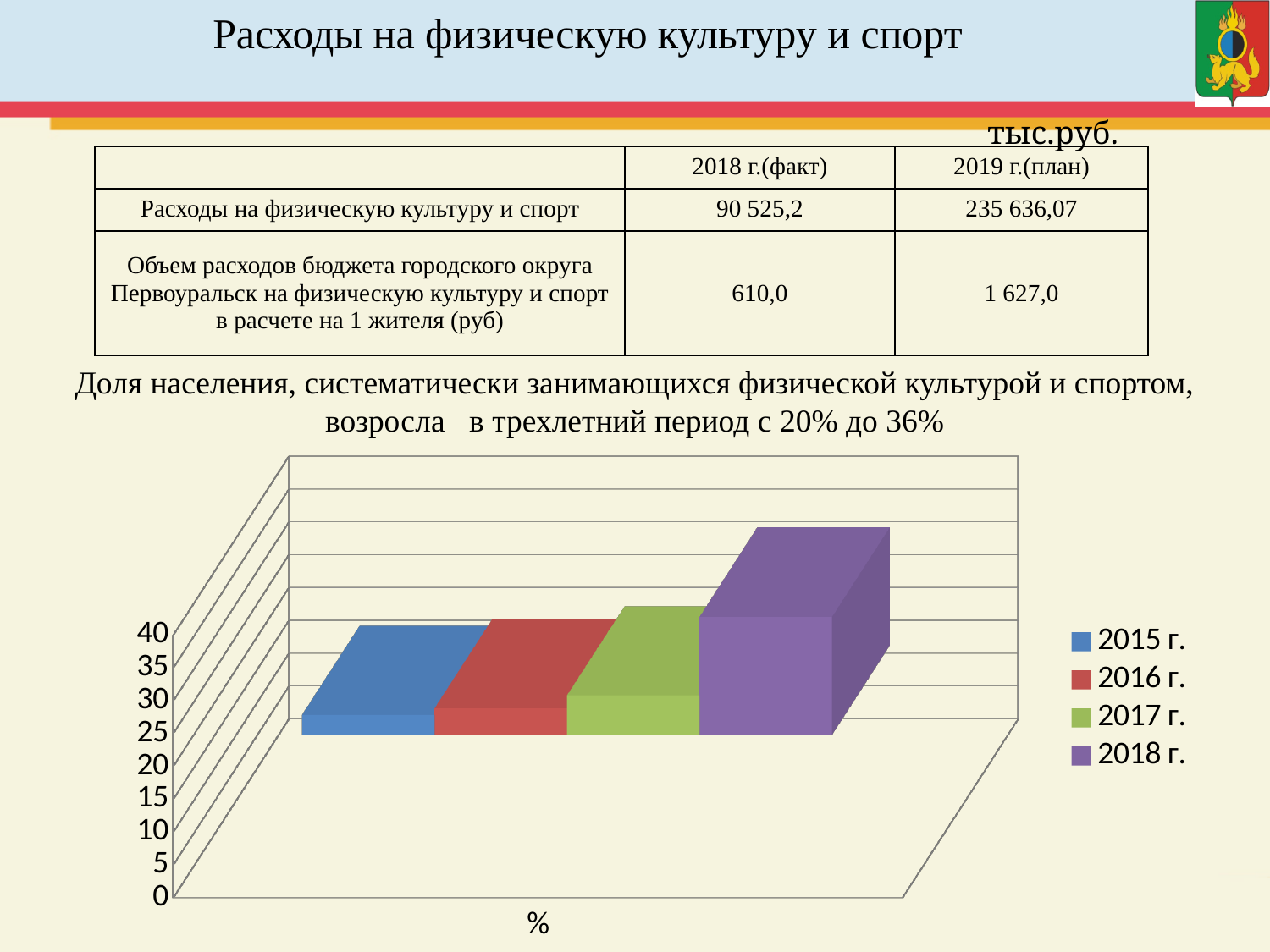
Is the value for 2015 г. greater or less than 40? less Which year has the shortest bar in the chart? 2015 г. What is the highest value shown on the chart's vertical axis? 40 Is the value for 2018 г. greater or less than 20? greater What kind of chart is shown on the slide? bar chart What unit label is shown below the chart's horizontal axis? % How many series does the chart legend list? 4 Do the bar values rise or fall from 2015 to 2018? rise Which is larger, the bar for 2018 г. or the bar for 2015 г.? 2018 г. How many bars are plotted in the chart? 4 Which year has the tallest bar in the chart? 2018 г.